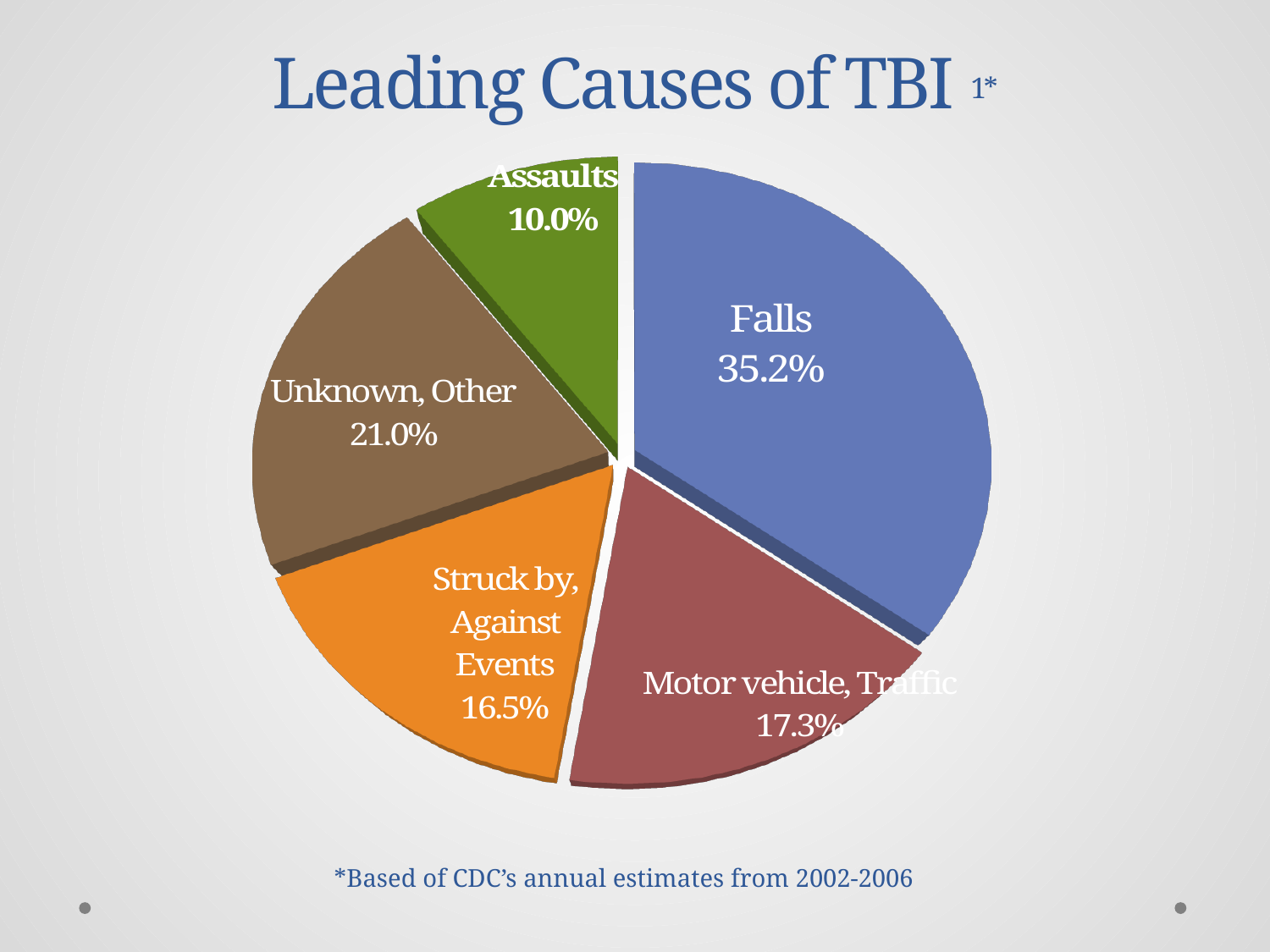
What percentage is shown for Struck by, Against Events? 16.5% What kind of chart is shown on the slide? Pie chart What is the title of the chart? Leading Causes of TBI What percentage is shown for Assaults? 10.0% What percentage is shown for Unknown, Other? 21.0% Which is larger, the share for Motor vehicle, Traffic or the share for Struck by, Against Events? Motor vehicle, Traffic What percentage of TBI cases is attributed to Falls? 35.2% Which cause has the smallest share of the pie? Assaults How many slices does the pie chart have? 5 Which cause has the largest share of the pie? Falls What percentage is shown for Motor vehicle, Traffic? 17.3% What is the difference in percentage points between Falls and Unknown, Other? 14.2